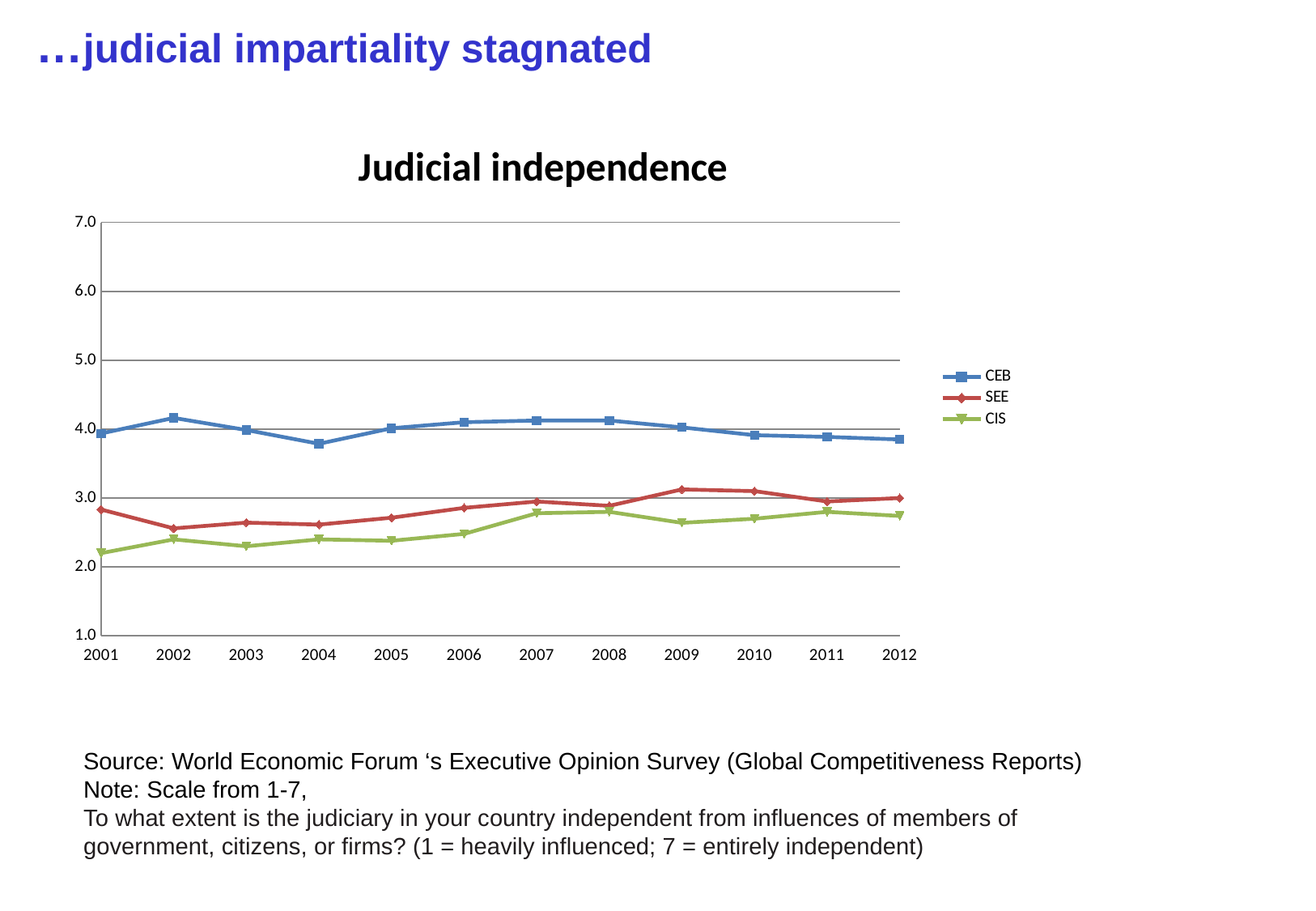
Is the value for CIS in 2001 greater or less than 2.0? greater Is the value for SEE in 2002 greater or less than 3.0? less How many series does the legend list? 3 Which series has the lowest value in 2001? CIS In 2001, which is larger: the value for SEE or the value for CIS? SEE Is the value for CEB in 2004 greater or less than 4.0? less What kind of chart is shown on the slide? line chart How many years are shown on the x axis? 12 Does the CEB line rise or fall from 2008 to 2012? fall Which series has the highest value in 2012? CEB What is the title of the chart? Judicial independence